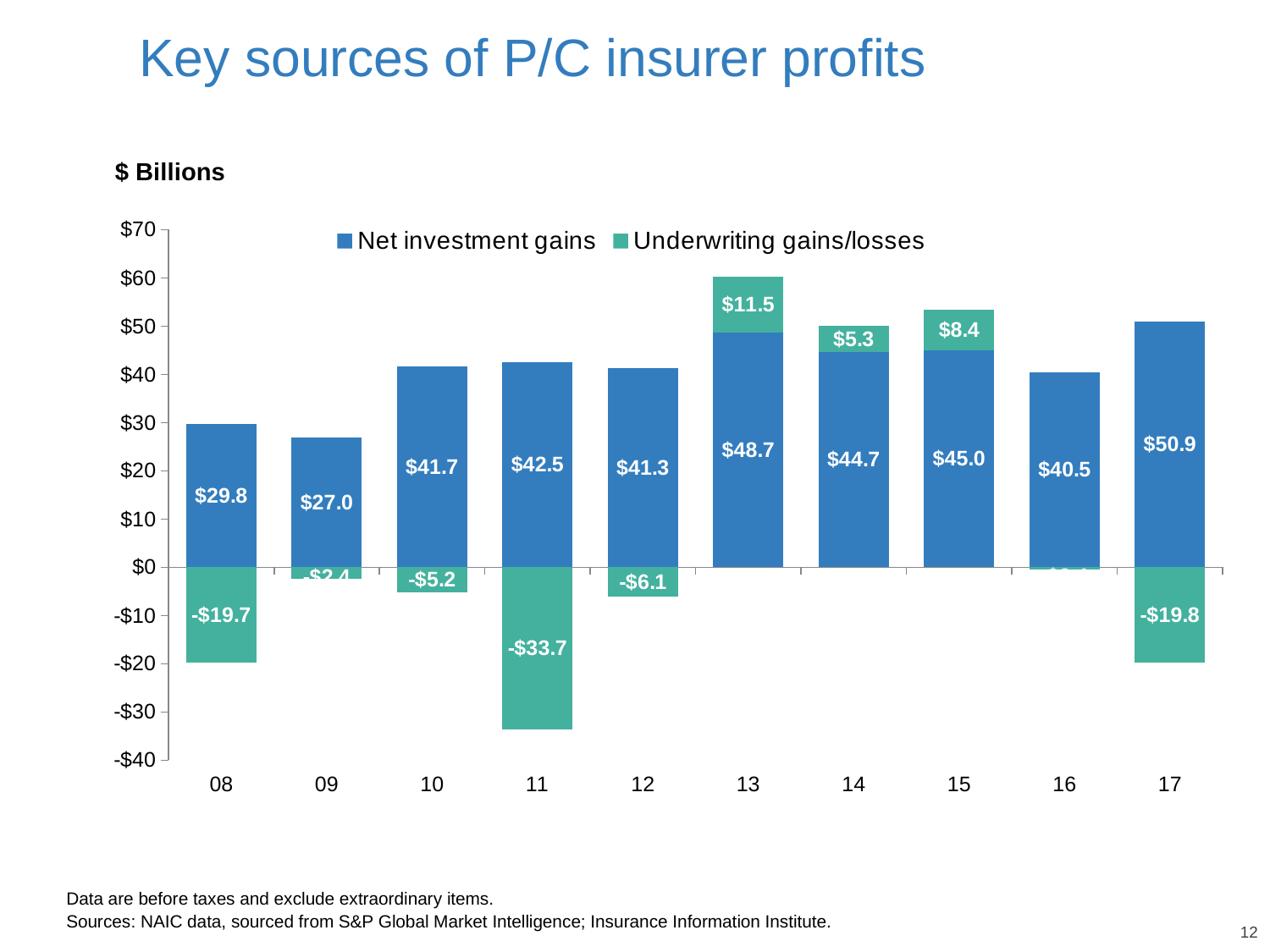
Which year has the lowest Net investment gains? 09 Which year has the highest Net investment gains? 17 Which year has the lowest Underwriting gains/losses? 11 What is the difference between Net investment gains in 17 and in 08? $21.1 What kind of chart is shown on the slide? Bar chart What is the value of Underwriting gains/losses for 11? -$33.7 What is the total of the stacked bar for 13 (Net investment gains plus Underwriting gains/losses)? $60.2 What is the value of Underwriting gains/losses for 14? $5.3 What is the value of Net investment gains for 13? $48.7 How many series does the legend list? 2 Which year has larger Underwriting gains/losses, 13 or 15? 13 How many years are shown on the x axis? 10